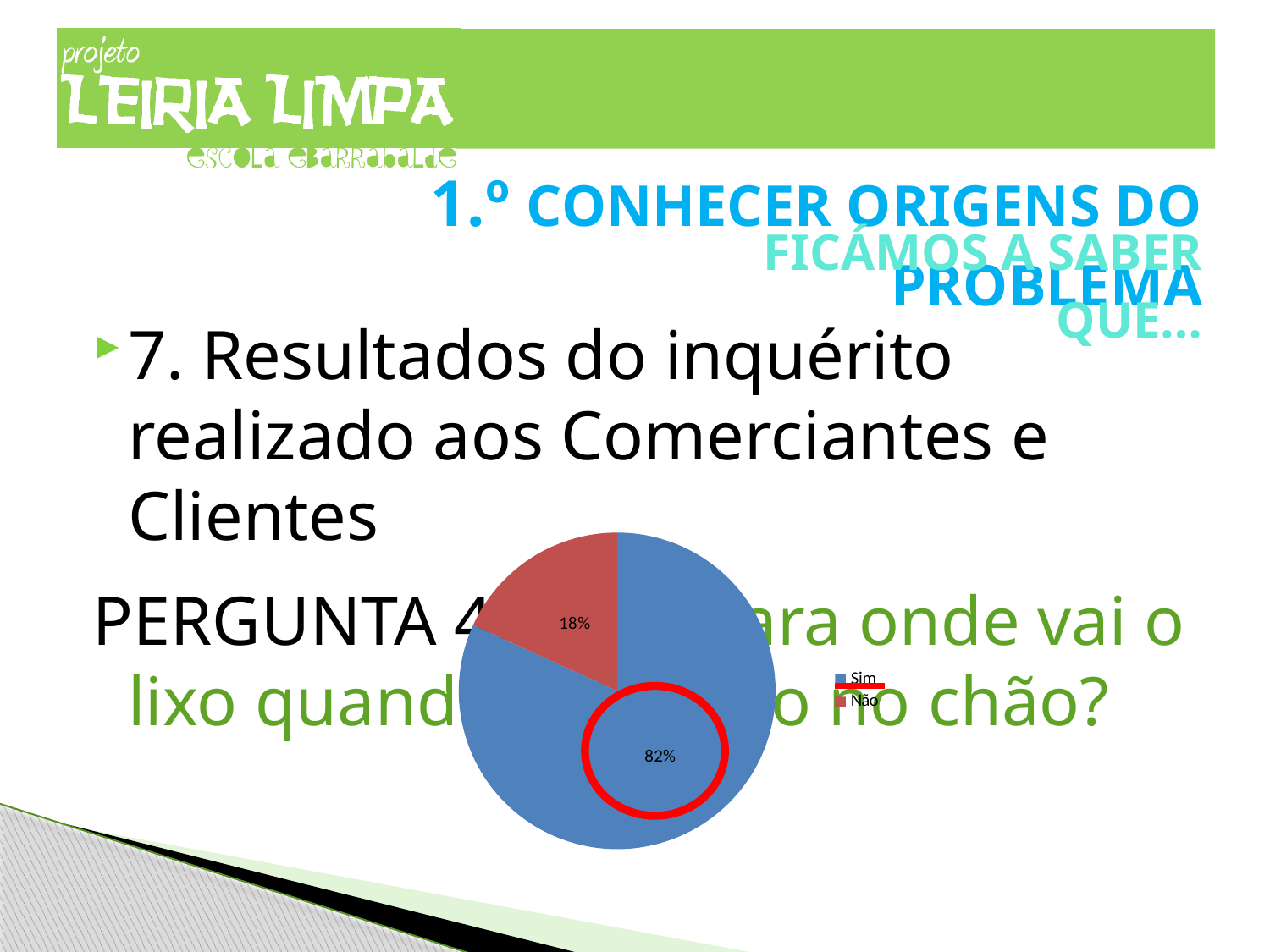
What percentage does the "Não" slice of the pie chart show? 18% Which slice of the pie chart is the smallest? Não What are the two legend entries of the pie chart? Sim and Não What colour is the "Não" slice in the pie chart? red How many slices does the pie chart have? 2 What percentage does the "Sim" slice of the pie chart show? 82% Which slice of the pie chart is the largest? Sim How many entries does the legend of the pie chart list? 2 What is the difference in percentage points between the "Sim" and "Não" slices? 64 What kind of chart is shown on the slide? pie chart Which is larger in the pie chart, "Sim" or "Não"? Sim What share of the pie does the "Sim" slice represent? 82%